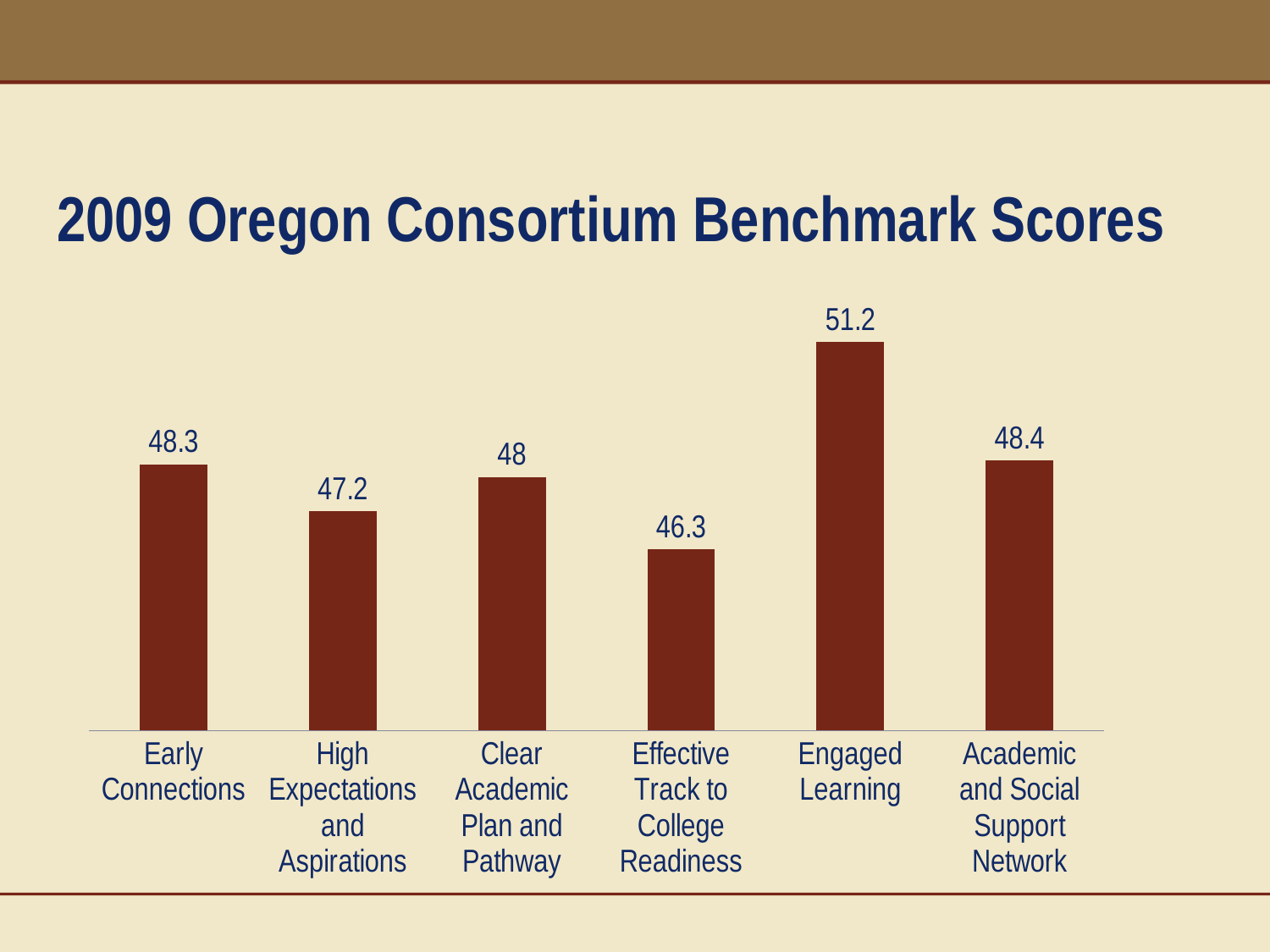
What is the difference between the scores for Engaged Learning and Effective Track to College Readiness? 4.9 What is the benchmark score for Clear Academic Plan and Pathway? 48 Which category has the lowest benchmark score? Effective Track to College Readiness How many categories are shown in the chart? 6 What is the benchmark score for Effective Track to College Readiness? 46.3 Which has a higher score, Early Connections or High Expectations and Aspirations? Early Connections What is the benchmark score for Early Connections? 48.3 What kind of chart is shown on the slide? Bar chart Which category has the highest benchmark score? Engaged Learning What is the title of the slide? 2009 Oregon Consortium Benchmark Scores What is the difference between the scores for Academic and Social Support Network and High Expectations and Aspirations? 1.2 What is the benchmark score for Engaged Learning? 51.2